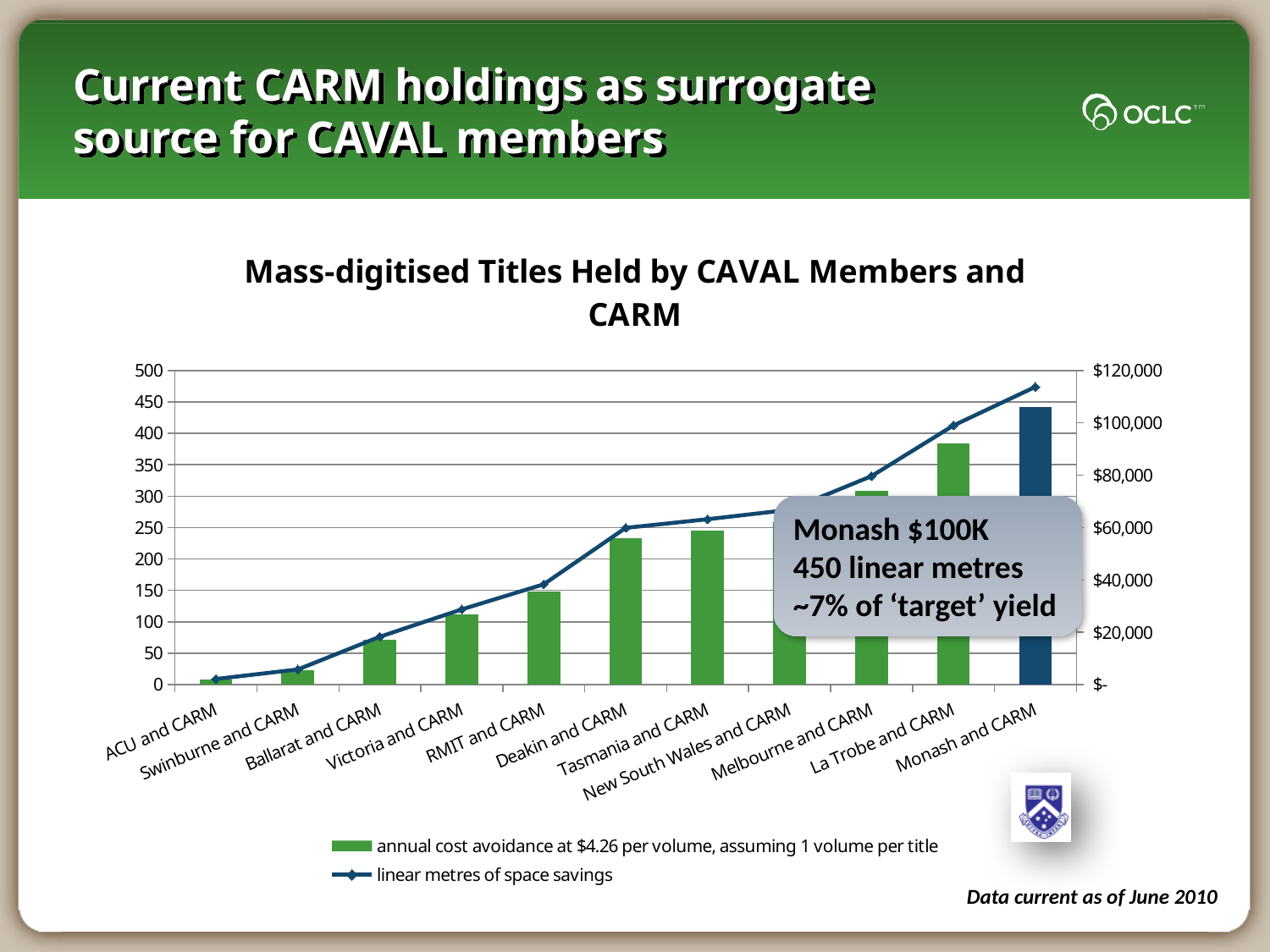
Which category has the tallest bar in the chart? Monash and CARM Do the values of the line series rise or fall moving from left to right along the x axis? Rise How many series does the chart legend list? 2 Is the line point for Monash and CARM greater or less than $100,000 on the right axis scale? greater Is the bar for Deakin and CARM greater or less than 200 on the left axis scale? greater Is the bar for Monash and CARM greater or less than 400 on the left axis scale? greater Which category has the shortest bar in the chart? ACU and CARM How many categories are shown along the x axis of the chart? 11 What is the title of the chart? Mass-digitised Titles Held by CAVAL Members and CARM Which has the taller bar, Melbourne and CARM or Deakin and CARM? Melbourne and CARM What kind of chart is shown on the slide? A combined bar and line chart